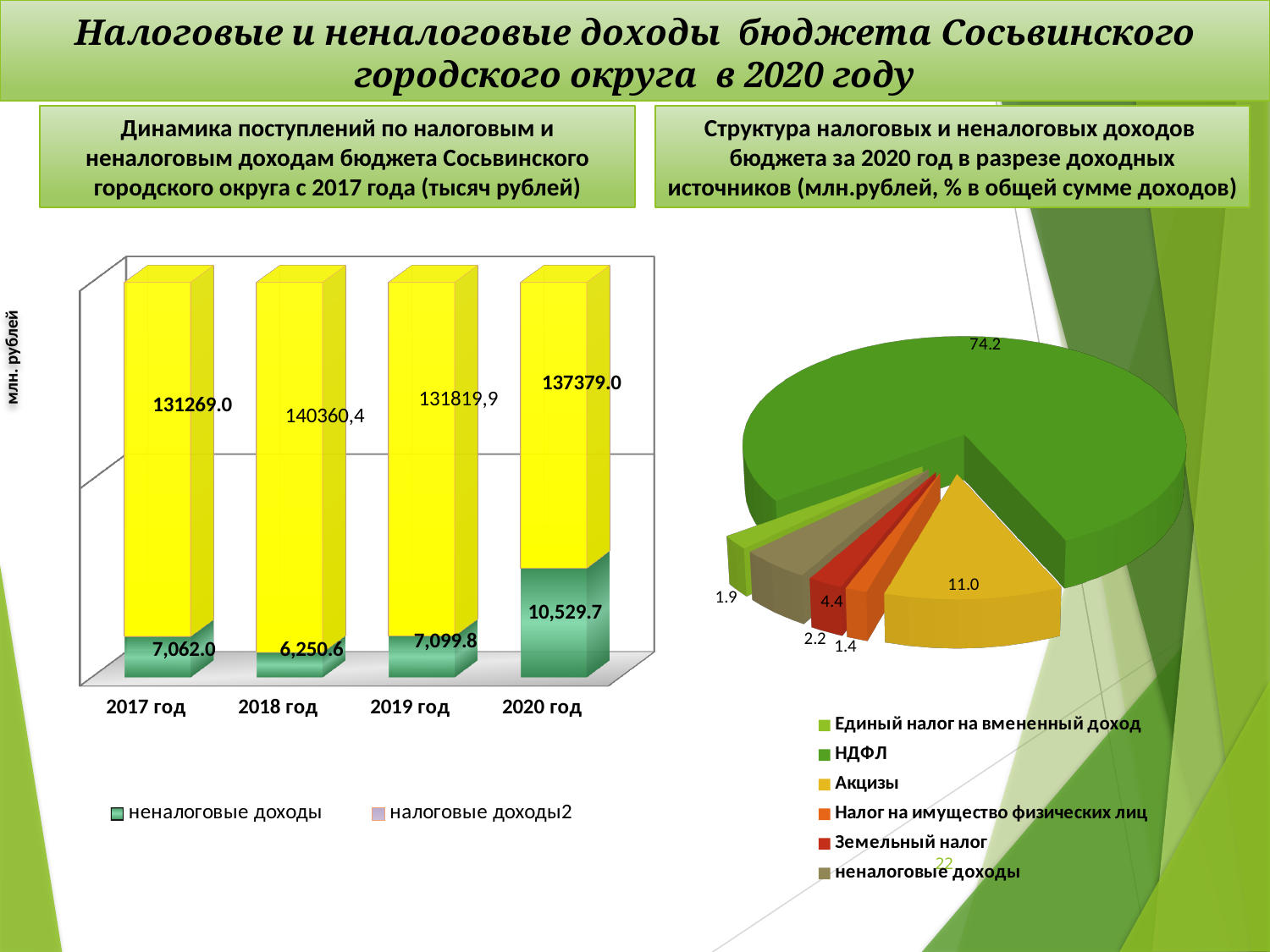
In the left chart (Динамика поступлений...), how many series does the legend list? 2 In the left chart (Динамика поступлений...), what is the value of налоговые доходы for 2018 год? 140360,4 In the left chart (Динамика поступлений...), what is the total of the stacked bar for 2020 год? 147,908.7 In the right pie chart (Структура налоговых и неналоговых доходов...), what is the value shown for Акцизы? 11.0 In the left chart (Динамика поступлений...), what is the value of неналоговые доходы for 2020 год? 10,529.7 In the right pie chart (Структура налоговых и неналоговых доходов...), how many categories does the legend list? 6 In the left chart (Динамика поступлений...), what is the difference between неналоговые доходы in 2020 год and 2019 год? 3,429.9 In the left chart (Динамика поступлений...), which year has the highest неналоговые доходы? 2020 год In the left chart (Динамика поступлений...), which year has the lowest неналоговые доходы? 2018 год In the right pie chart (Структура налоговых и неналоговых доходов...), which is larger: Земельный налог or Налог на имущество физических лиц? Земельный налог What type of chart is the left chart (Динамика поступлений...)? Stacked bar chart In the right pie chart (Структура налоговых и неналоговых доходов...), which category has the largest share? НДФЛ